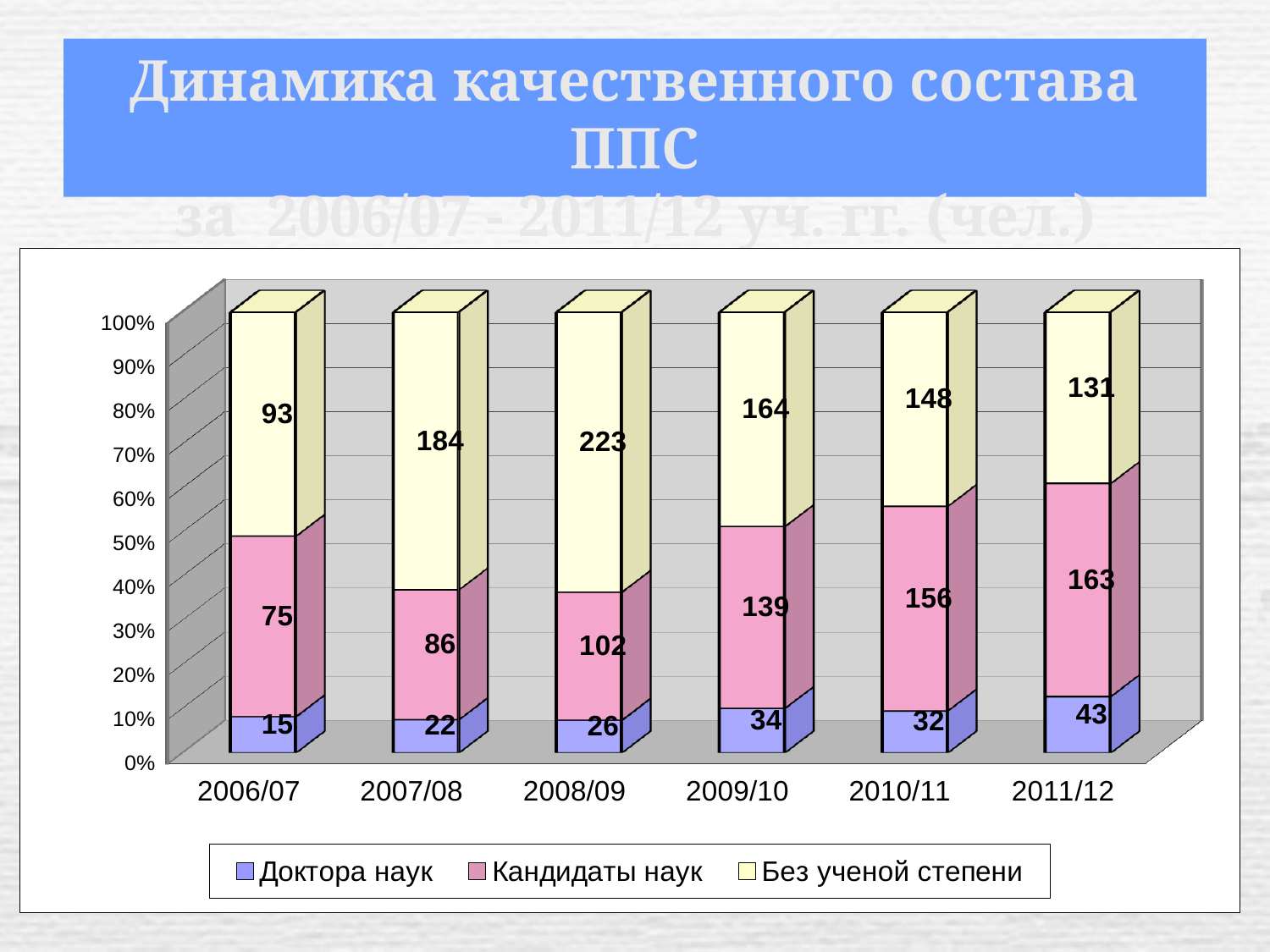
In which year is the value for Без ученой степени highest? 2008/09 Which is larger: the Без ученой степени value for 2009/10 or for 2011/12? 2009/10 What kind of chart is shown on the slide? Stacked bar chart What is the total of the stacked bar for 2006/07? 183 How many academic years are shown on the x axis? 6 What is the difference between the Кандидаты наук values for 2010/11 and 2006/07? 81 Do the values for Кандидаты наук rise or fall from 2006/07 to 2011/12? Rise What is the value for Кандидаты наук in 2011/12? 163 What is the value for Доктора наук in 2009/10? 34 What is the value for Без ученой степени in 2008/09? 223 How many series does the legend list? 3 In which year is the value for Доктора наук lowest? 2006/07